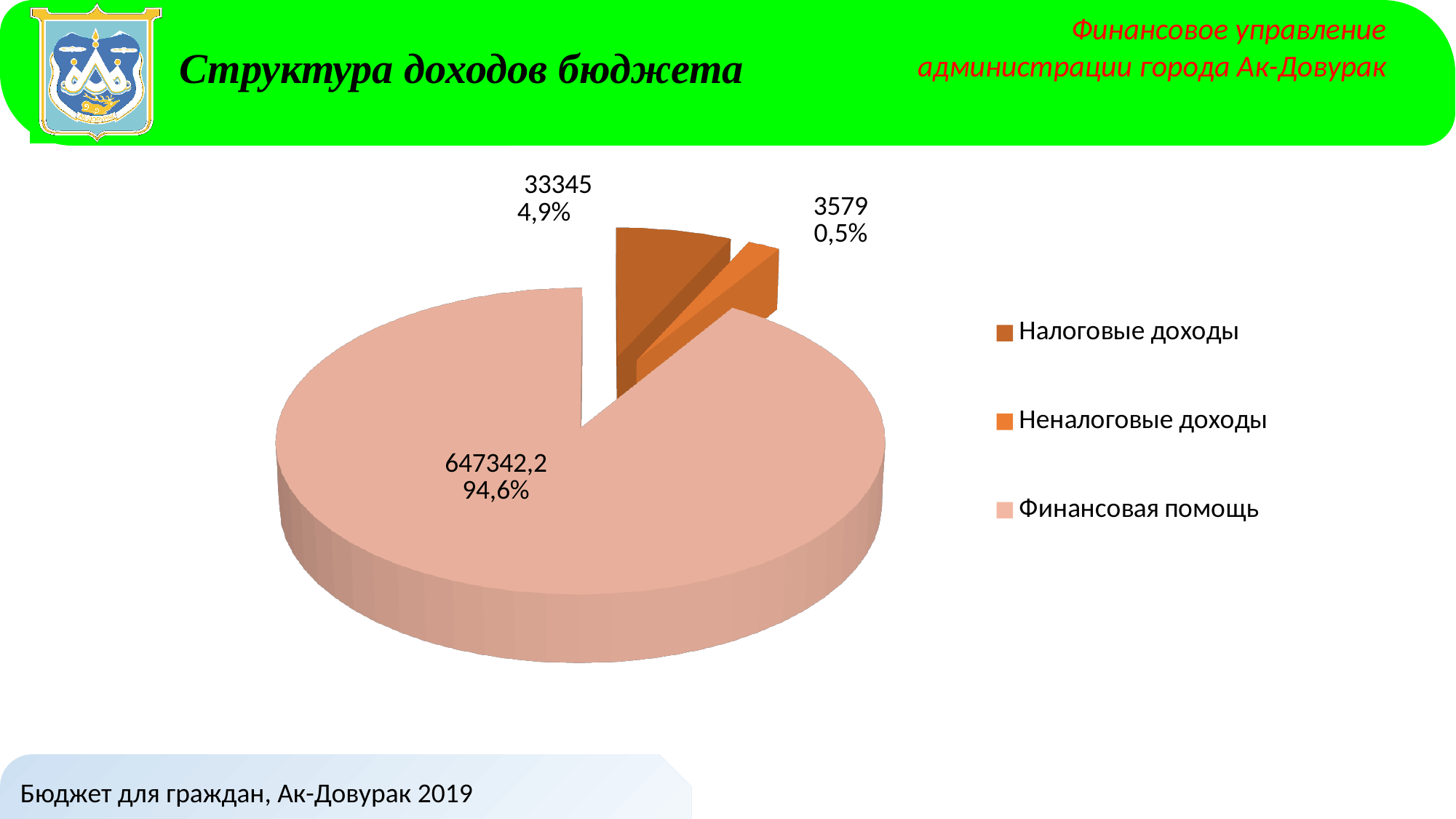
What is the difference between the values for Налоговые доходы and Неналоговые доходы? 29766 Which is larger, Налоговые доходы or Неналоговые доходы? Налоговые доходы What share of the pie does Финансовая помощь take? 94,6% What share of the pie does Неналоговые доходы take? 0,5% What value is shown for Налоговые доходы? 33345 What value is shown for Финансовая помощь? 647342,2 Which category has the largest slice? Финансовая помощь What share of the pie does Налоговые доходы take? 4,9% What value is shown for Неналоговые доходы? 3579 How many categories does the pie chart show? 3 Which category has the smallest slice? Неналоговые доходы What kind of chart is shown on the slide? Pie chart